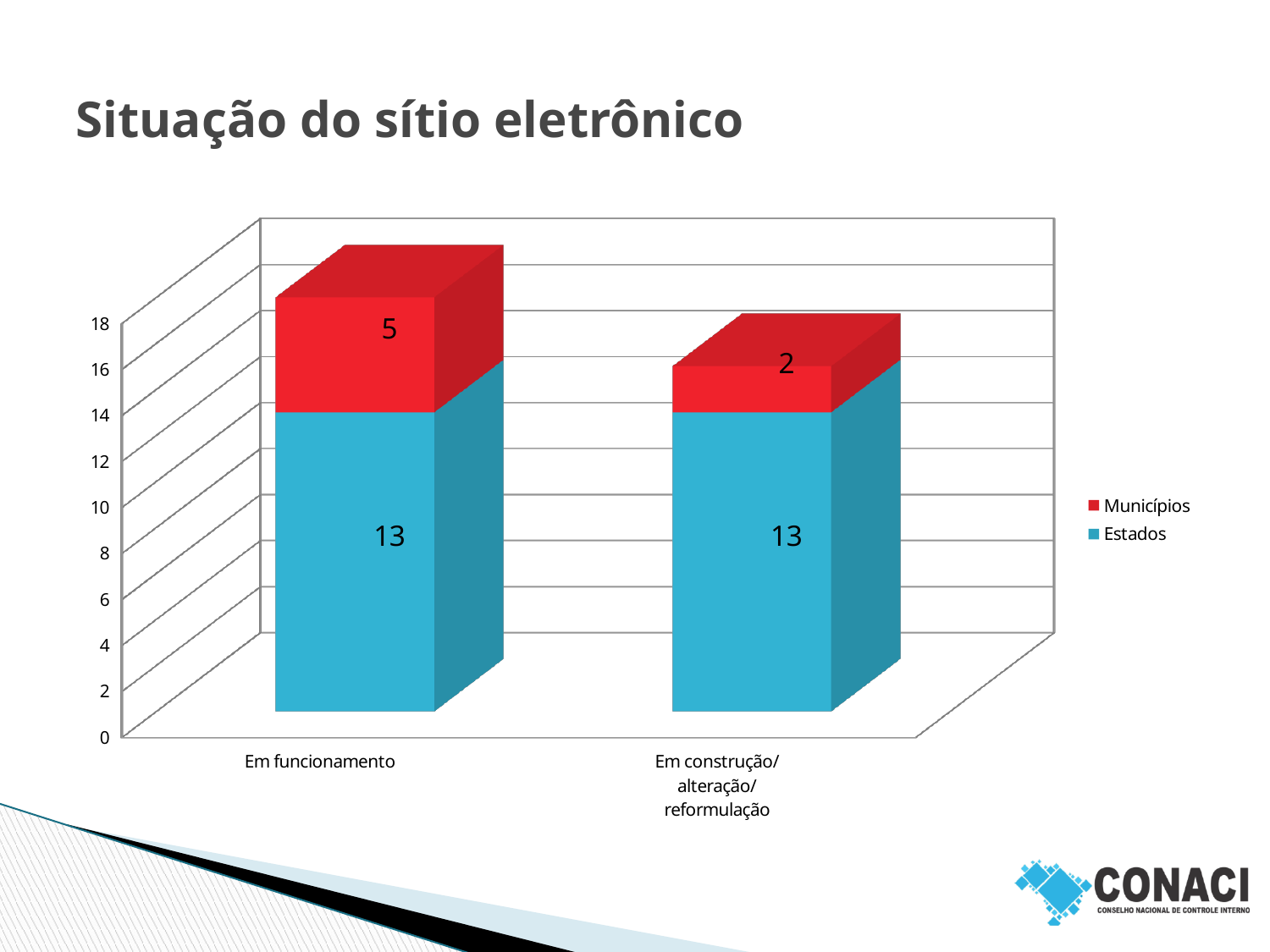
What is the total of the stacked bar for 'Em construção/alteração/reformulação'? 15 What is the value for Municípios in the 'Em funcionamento' category? 5 Which category has the highest value for Municípios? Em funcionamento What is the value for Municípios in the 'Em construção/alteração/reformulação' category? 2 How many series does the legend list? 2 What is the value for Estados in the 'Em construção/alteração/reformulação' category? 13 What kind of chart is shown on the slide? Stacked bar chart Which is larger: the Municípios value for 'Em funcionamento' or for 'Em construção/alteração/reformulação'? Em funcionamento How many categories are shown on the x axis? 2 What is the value for Estados in the 'Em funcionamento' category? 13 What is the difference between the Municípios values for 'Em funcionamento' and 'Em construção/alteração/reformulação'? 3 What is the total of the stacked bar for 'Em funcionamento'? 18